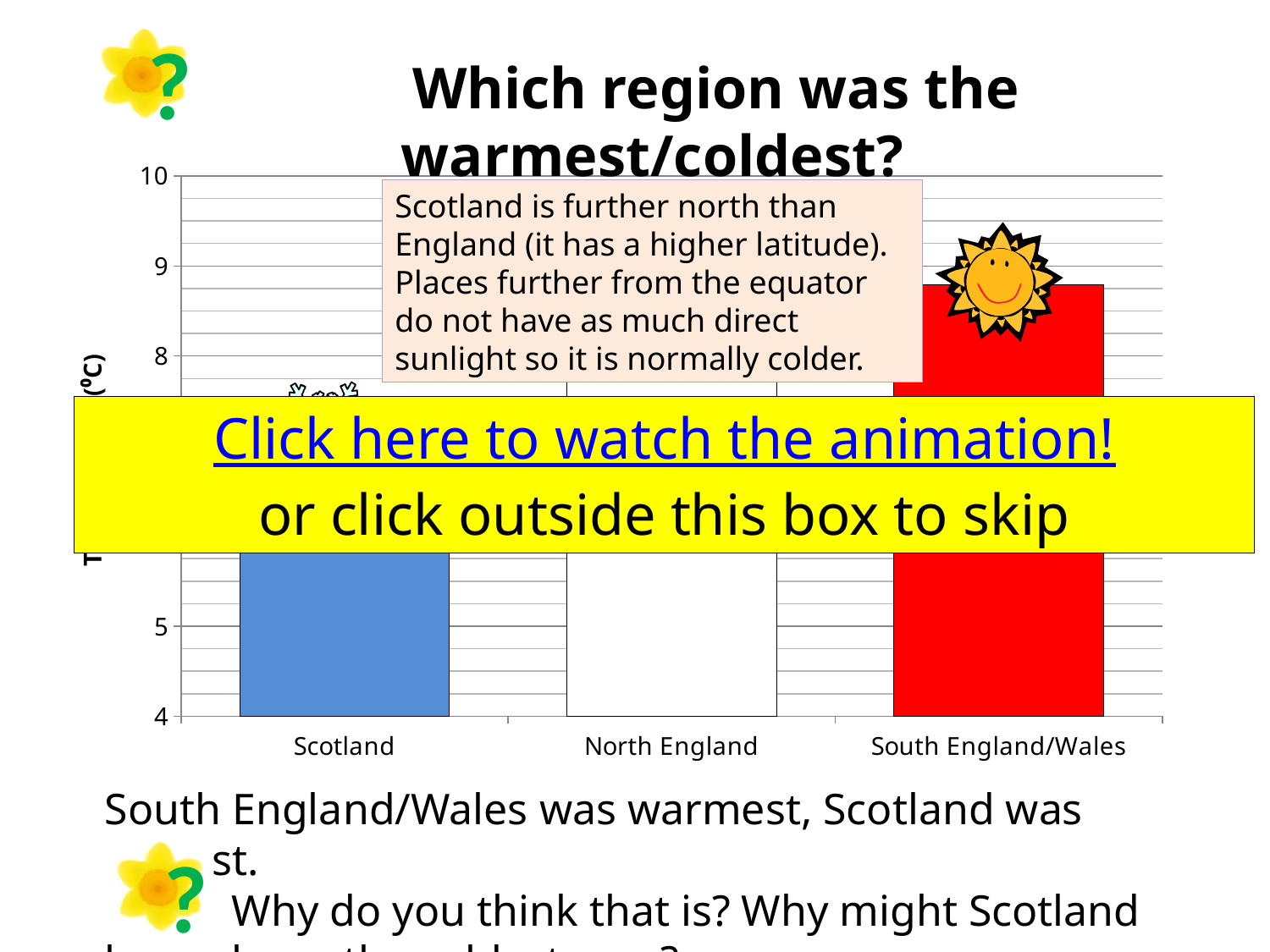
Which is larger, the value for North England or the value for South England/Wales? South England/Wales Is the value for South England/Wales greater or less than 8? greater Which is larger, the value for South England/Wales or the value for Scotland? South England/Wales What is the title of the chart? Which region was the warmest/coldest? Is the value for Scotland greater or less than 8? less What kind of chart is shown on the slide? bar chart How many regions are plotted on the chart? 3 Which region has the highest bar on the chart? South England/Wales What colour is the bar for South England/Wales? red Is the value for South England/Wales greater or less than 9? less Which region was the coldest according to the chart? Scotland